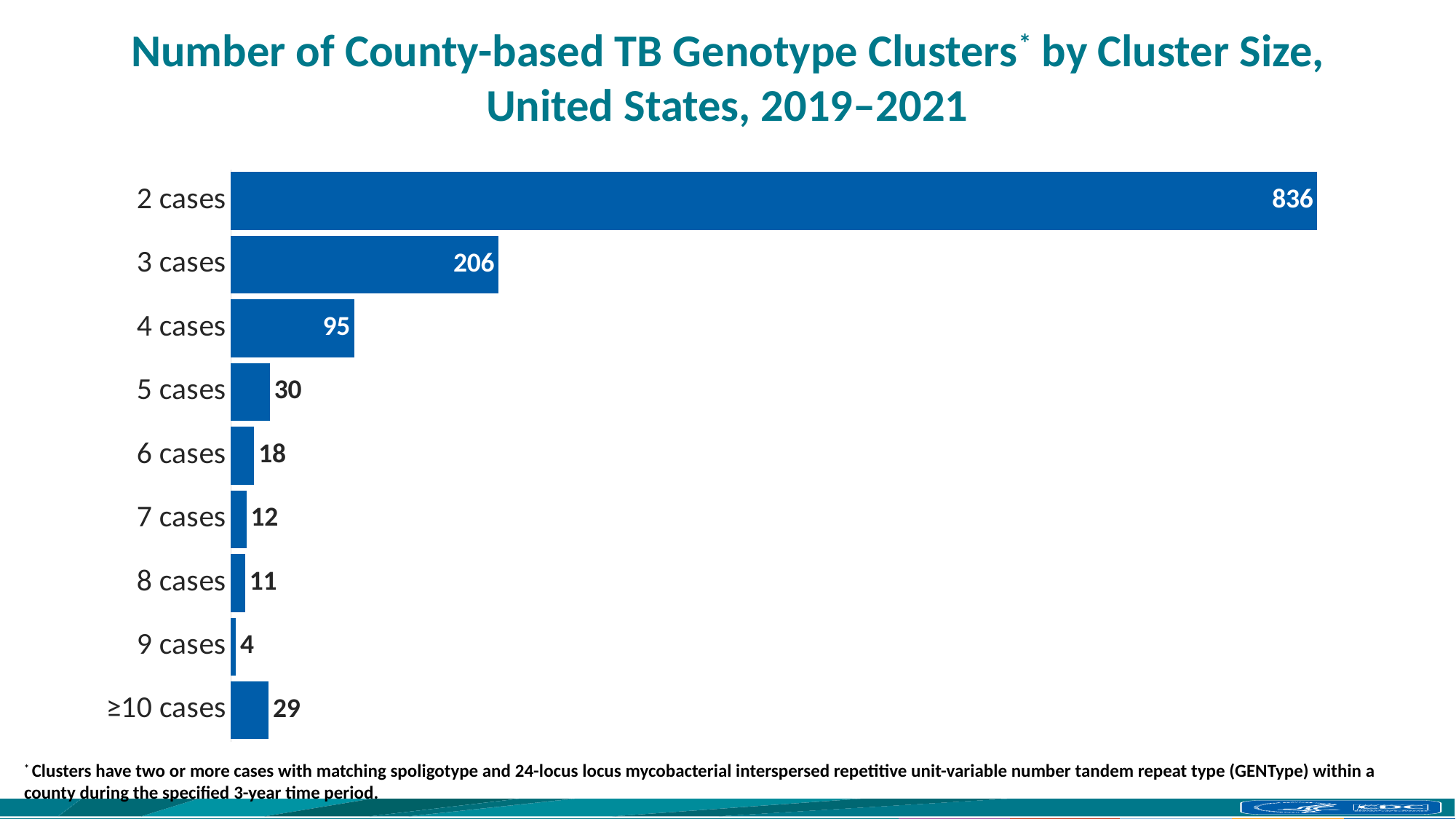
What is the number of clusters with 3 cases? 206 What is the difference between the number of clusters with 2 cases and the number with 3 cases? 630 Do the values generally rise or fall as cluster size increases from 2 cases to 9 cases? Fall What is the difference between the number of clusters with 4 cases and with 5 cases? 65 How many clusters had ≥10 cases? 29 What kind of chart is shown on the slide? Bar chart Which cluster size category has the lowest number of clusters? 9 cases What time period does the chart title cover? 2019–2021 How many county-based TB genotype clusters had 2 cases? 836 Which has more clusters: 8 cases or ≥10 cases? ≥10 cases Which cluster size category has the highest number of clusters? 2 cases How many cluster size categories are shown in the chart? 9